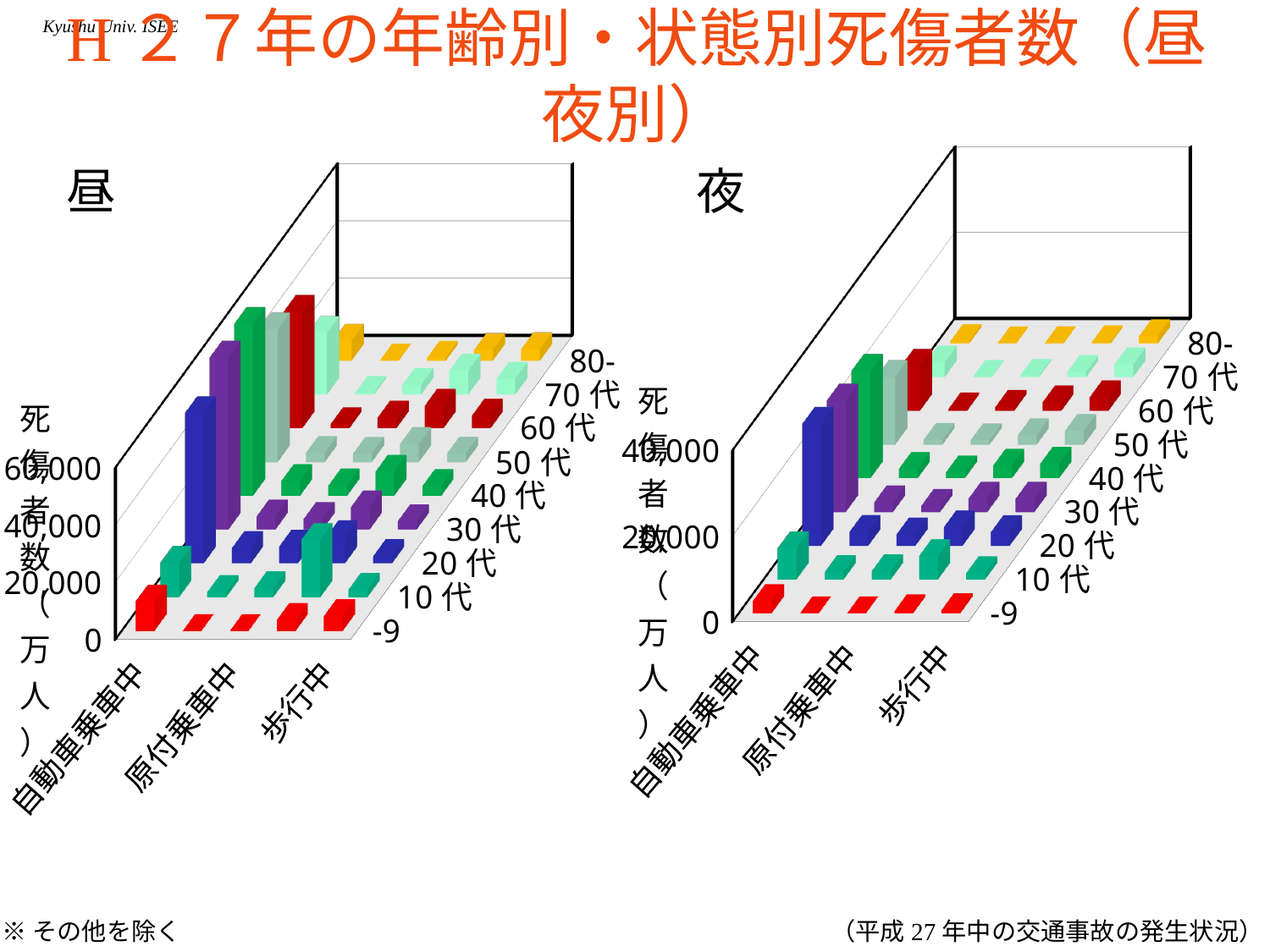
What is the highest value shown on the vertical axis of the 昼 chart? 60,000 What kind of chart is the 昼 chart on the left? bar chart In the 昼 chart, which category on the horizontal axis has the tallest bar? 自動車乗車中 In the 昼 chart, for the 20代 age group, which is larger: 自動車乗車中 or 歩行中? 自動車乗車中 In the 昼 chart, is the value for 自動車乗車中 in the -9 age group greater or less than 20,000? less In the 夜 chart, for the 20代 age group, which is larger: 自動車乗車中 or 原付乗車中? 自動車乗車中 How many age groups are shown along the depth axis of the 夜 chart? 9 In the 夜 chart, is the value for 歩行中 in the 80- age group greater or less than 20,000? less What is the label of the chart on the left side of the slide? 昼 In the 夜 chart, which category on the horizontal axis has the tallest bar? 自動車乗車中 How many categories are shown along the horizontal axis of the 昼 chart? 3 In the 昼 chart, for the 30代 age group, which is larger: 自動車乗車中 or 原付乗車中? 自動車乗車中